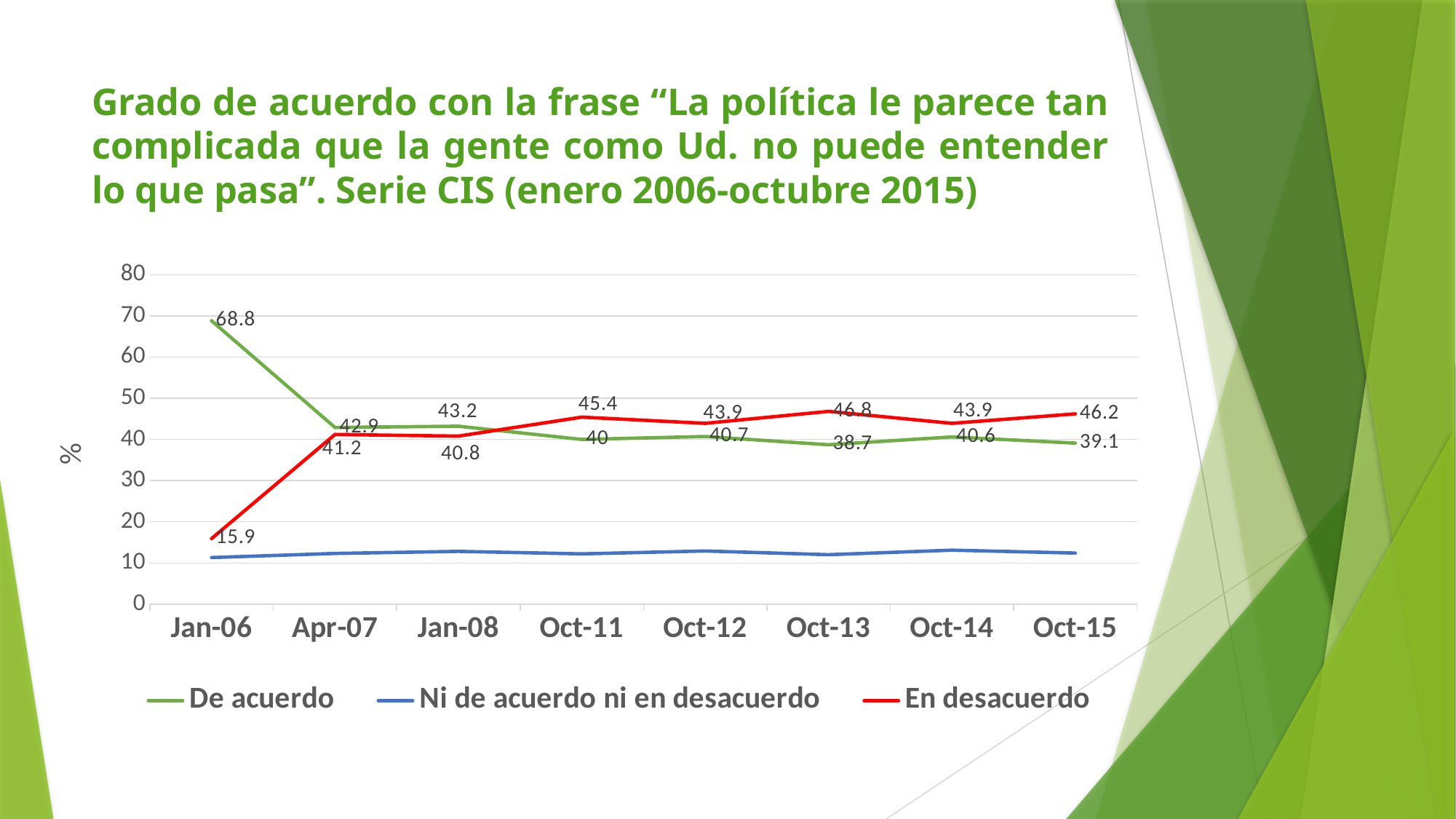
At Oct-11, which is larger: De acuerdo or En desacuerdo? En desacuerdo What kind of chart is shown on the slide? line chart How many series does the legend list? 3 At which date does En desacuerdo reach its highest value? Oct-13 What is the difference between En desacuerdo and De acuerdo at Oct-13? 8.1 What is the difference between De acuerdo and En desacuerdo at Jan-06? 52.9 How many dates are shown on the x axis? 8 At which date is De acuerdo at its lowest value? Oct-13 What is the value for En desacuerdo at Oct-15? 46.2 Does the De acuerdo line rise or fall between Jan-06 and Apr-07? fall What is the value for De acuerdo at Jan-06? 68.8 Is the value for Ni de acuerdo ni en desacuerdo at Oct-12 greater or less than 20? less